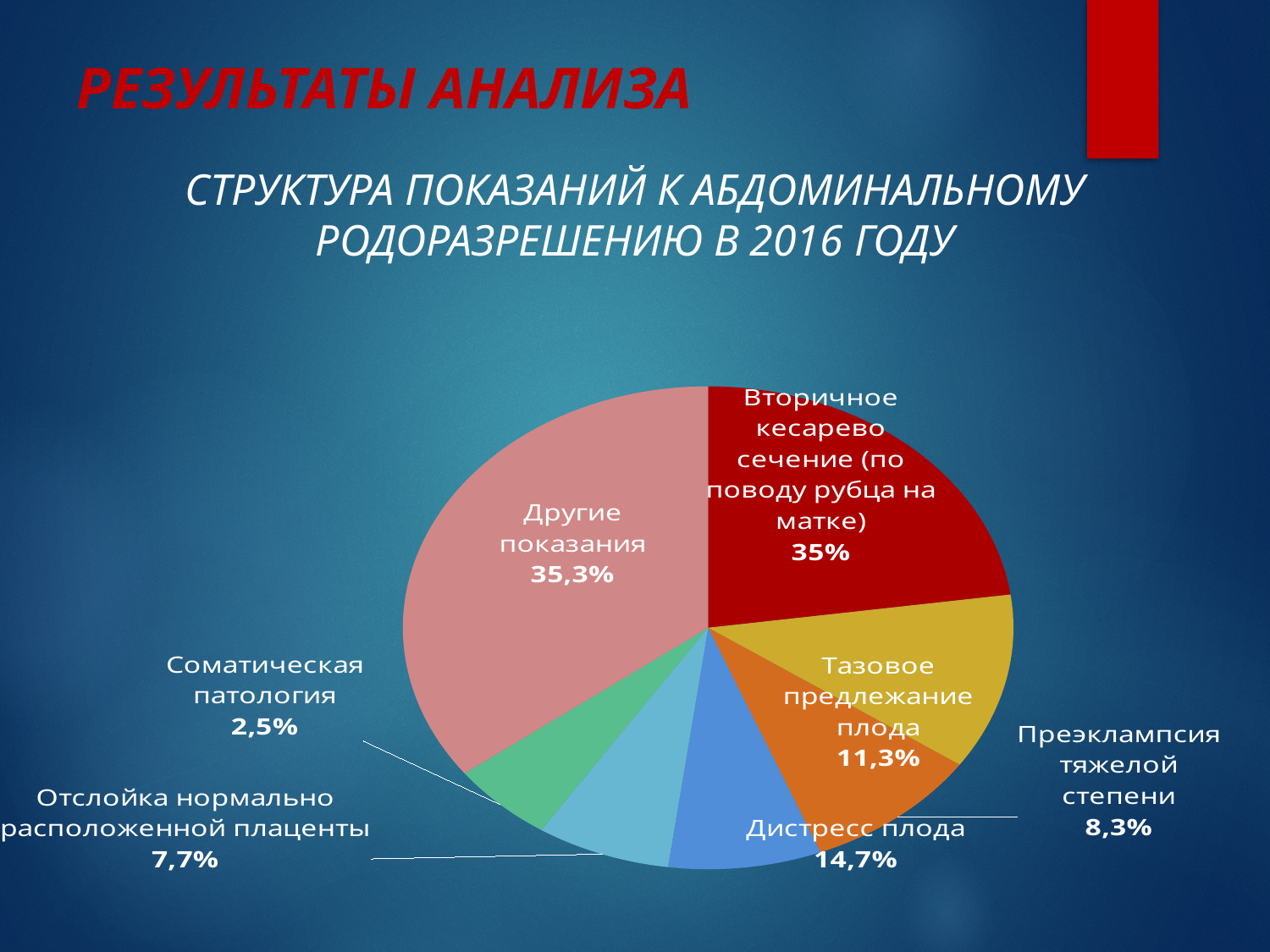
What kind of chart is shown on the slide? Pie chart What is the value for "Дистресс плода"? 14,7% How many categories (slices) does the pie chart have? 7 Which is larger: "Преэклампсия тяжелой степени" or "Отслойка нормально расположенной плаценты"? Преэклампсия тяжелой степени What is the value for "Отслойка нормально расположенной плаценты"? 7,7% Which category has the smallest slice of the pie? Соматическая патология Which category has the largest slice of the pie? Другие показания What is the value for "Тазовое предлежание плода"? 11,3% What share of the pie does "Другие показания" have? 35,3% What is the value for "Вторичное кесарево сечение (по поводу рубца на матке)"? 35% What is the difference between the values for "Дистресс плода" and "Тазовое предлежание плода"? 3,4% What is the value for "Преэклампсия тяжелой степени"? 8,3%